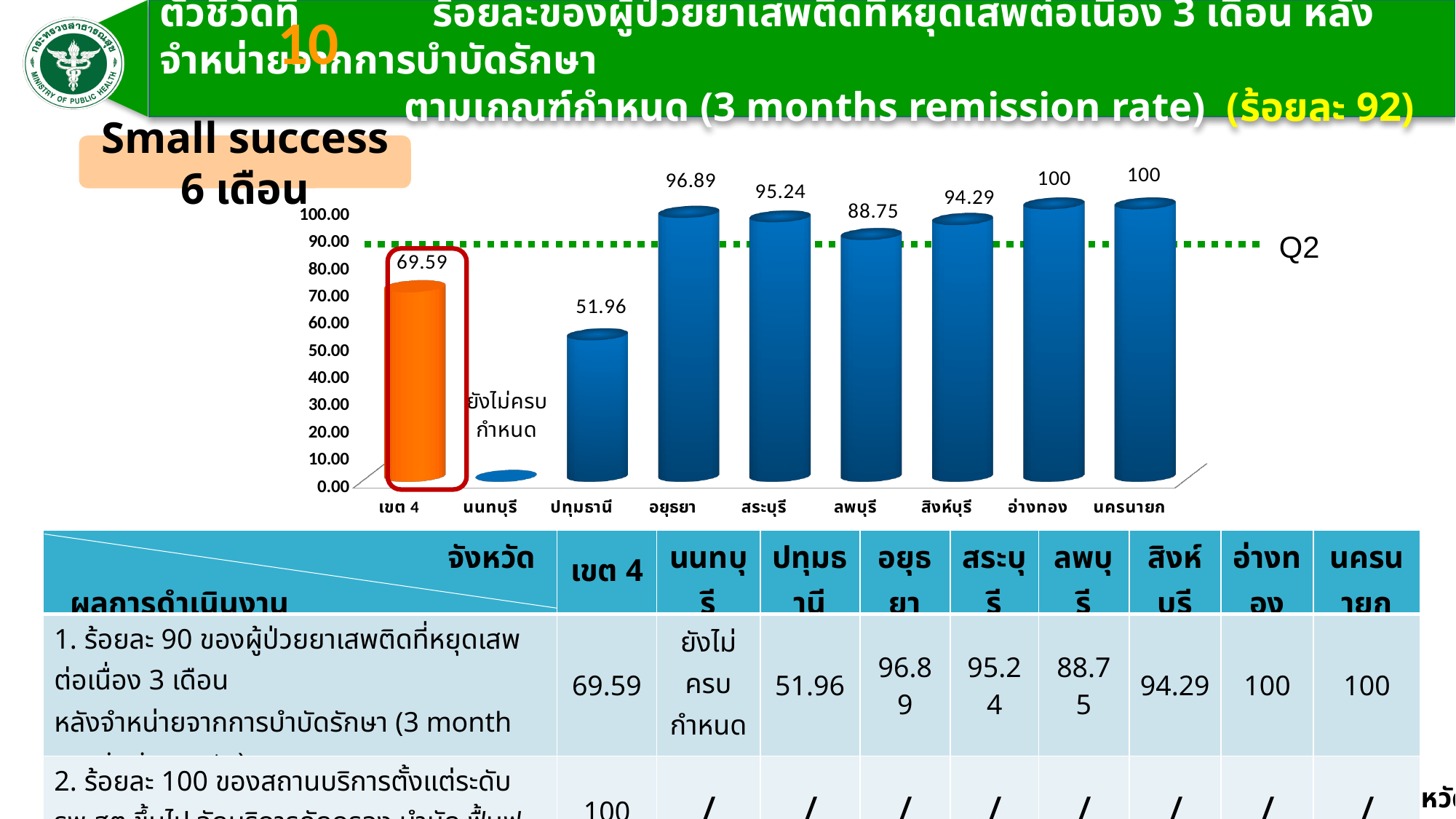
What is the difference between the values for อยุธยา and สระบุรี? 1.65 What is the value for ลพบุรี in the chart? 88.75 What is the value for สิงห์บุรี in the chart? 94.29 What is the value for ปทุมธานี in the chart? 51.96 Which is larger, the value for สระบุรี or the value for สิงห์บุรี? สระบุรี Which category has the lowest plotted value in the chart (excluding the category with no data)? ปทุมธานี What kind of chart is shown on the slide? bar chart What is the difference between the values for เขต 4 and ปทุมธานี? 17.63 What is the value for เขต 4 in the chart? 69.59 Is the value for ลพบุรี greater or less than 90.00? less What is the value for อยุธยา in the chart? 96.89 How many categories are shown on the x axis of the chart? 9